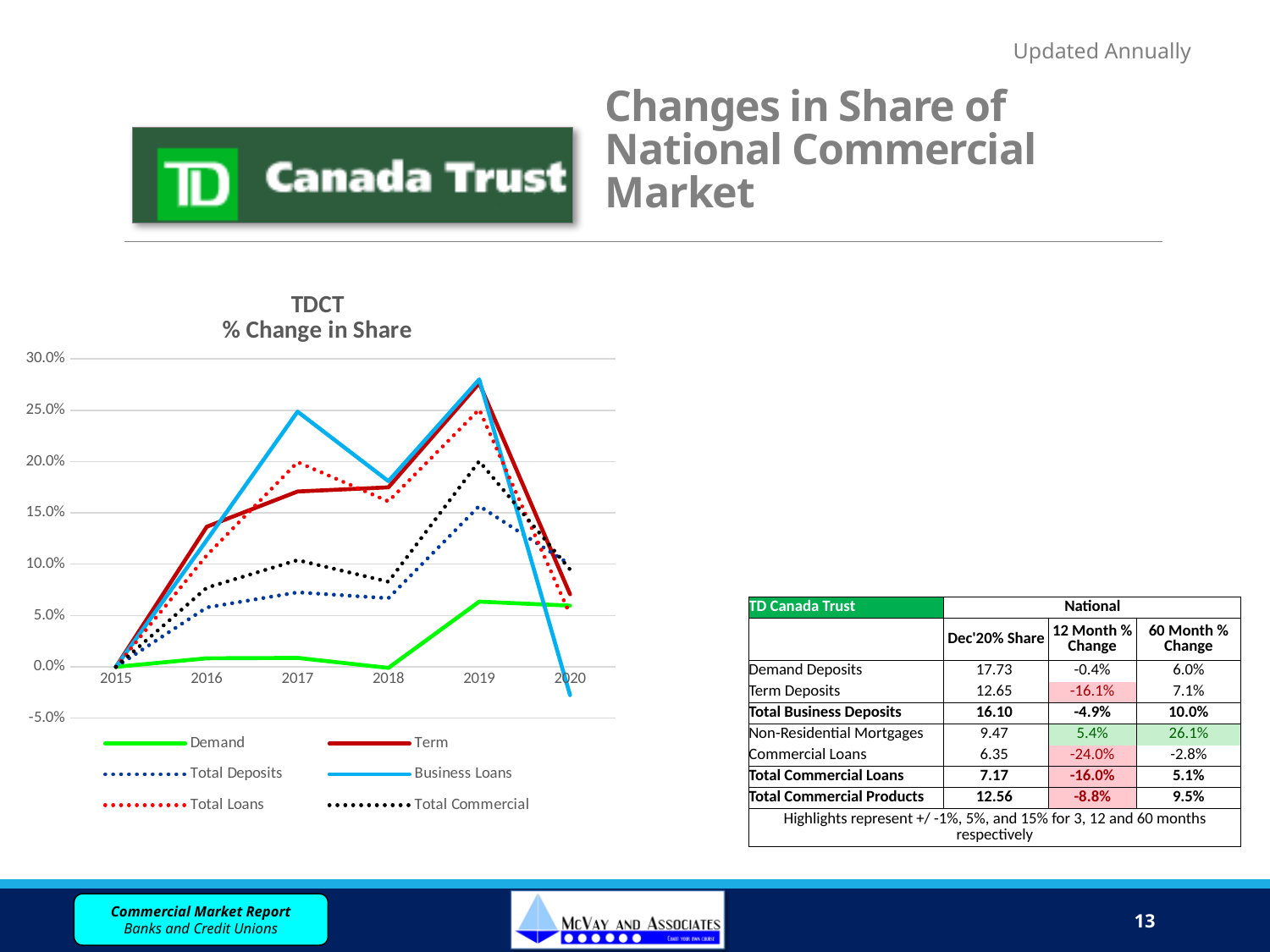
Does the Business Loans series rise or fall from 2019 to 2020? fall How many series does the legend of the TDCT % Change in Share chart list? 6 Is the value for Business Loans in 2020 greater or less than 0.0%? less Which series has the lowest value in 2019? Demand How many years are shown on the x axis of the TDCT % Change in Share chart? 6 In which year does the Business Loans series reach its peak? 2019 Is the value for Term in 2019 greater or less than 25.0%? greater Which series has the highest value in 2017? Business Loans In 2018, which is larger: the value for Term or the value for Demand? Term What kind of chart is the TDCT % Change in Share chart? line chart Is the value for Business Loans in 2017 greater or less than 20.0%? greater